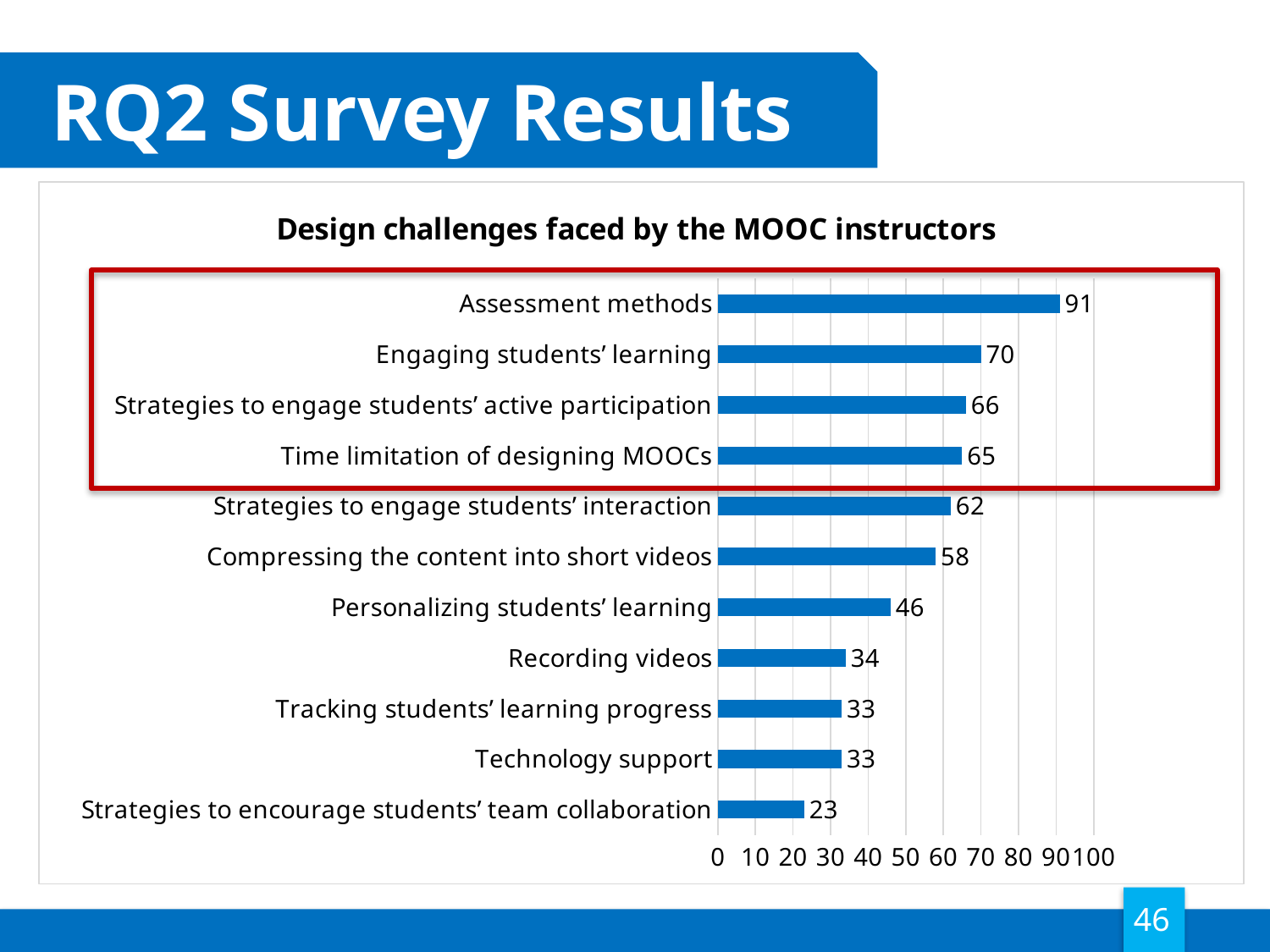
What is the value for Time limitation of designing MOOCs? 65 What is the value for Assessment methods? 91 What is the title of the chart? Design challenges faced by the MOOC instructors Which design challenge has the highest value? Assessment methods Which is larger, the value for Compressing the content into short videos or the value for Personalizing students' learning? Compressing the content into short videos What is the difference between the values for Assessment methods and Engaging students' learning? 21 What is the value for Recording videos? 34 What kind of chart is shown on the slide? Bar chart Is the value for Strategies to engage students' interaction greater or less than 50? greater How many design challenges are shown in the chart? 11 How many categories are enclosed by the red box on the chart? 4 Which design challenge has the lowest value? Strategies to encourage students' team collaboration